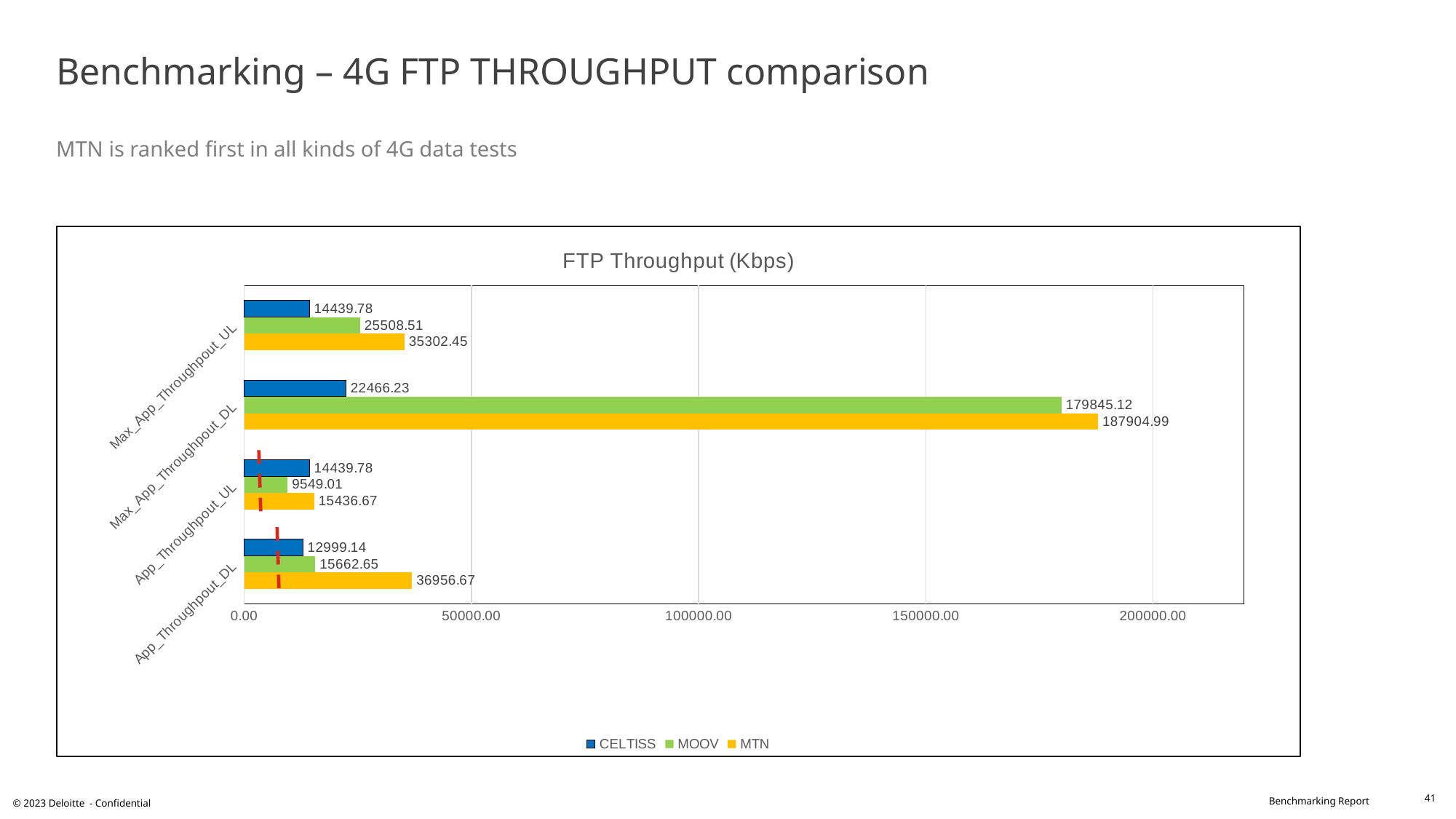
Which series has the lowest value for App_Throughpout_UL? MOOV What is the difference between the MTN and CELTISS values for App_Throughpout_DL? 23957.53 How many series does the legend list? 3 What is the MTN value for Max_App_Throughpout_DL? 187904.99 What kind of chart is shown on the slide? Bar chart What is the difference between the MTN and MOOV values for Max_App_Throughpout_DL? 8059.87 Which series has the highest value for Max_App_Throughpout_UL? MTN What is the CELTISS value for App_Throughpout_DL? 12999.14 What is the MOOV value for App_Throughpout_UL? 9549.01 How many categories are shown on the chart? 4 Is the MOOV value for Max_App_Throughpout_DL greater or less than 150000.00? greater Which is larger for Max_App_Throughpout_UL, the MOOV value or the CELTISS value? MOOV